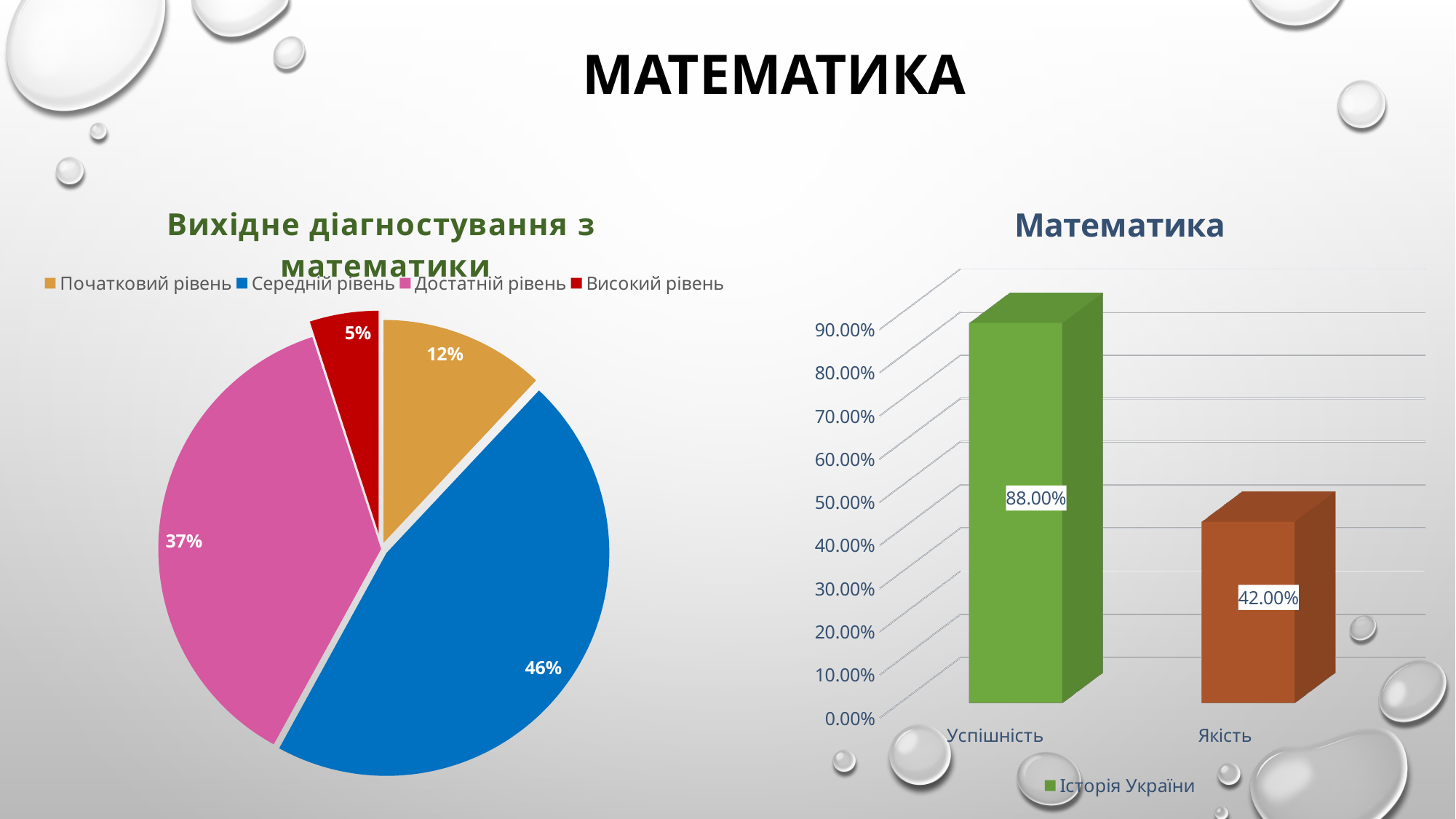
In the pie chart 'Вихідне діагностування з математики', what is the difference between the shares for Середній рівень and Достатній рівень? 9% In the bar chart 'Математика', what is the value for Якість? 42.00% In the bar chart 'Математика', what is the difference between Успішність and Якість? 46.00% In the pie chart 'Вихідне діагностування з математики', which level has the smallest slice? Високий рівень What type of chart is the chart titled 'Математика' on the right? Bar chart In the pie chart 'Вихідне діагностування з математики', which colour is used for Високий рівень? Red In the pie chart 'Вихідне діагностування з математики', what is the share for Достатній рівень? 37% In the pie chart 'Вихідне діагностування з математики', what is the share for Середній рівень? 46% In the bar chart 'Математика', what is the value for Успішність? 88.00% In the pie chart 'Вихідне діагностування з математики', how many slices are there? 4 In the pie chart 'Вихідне діагностування з математики', which level has the largest slice? Середній рівень In the pie chart 'Вихідне діагностування з математики', what is the share for Початковий рівень? 12%